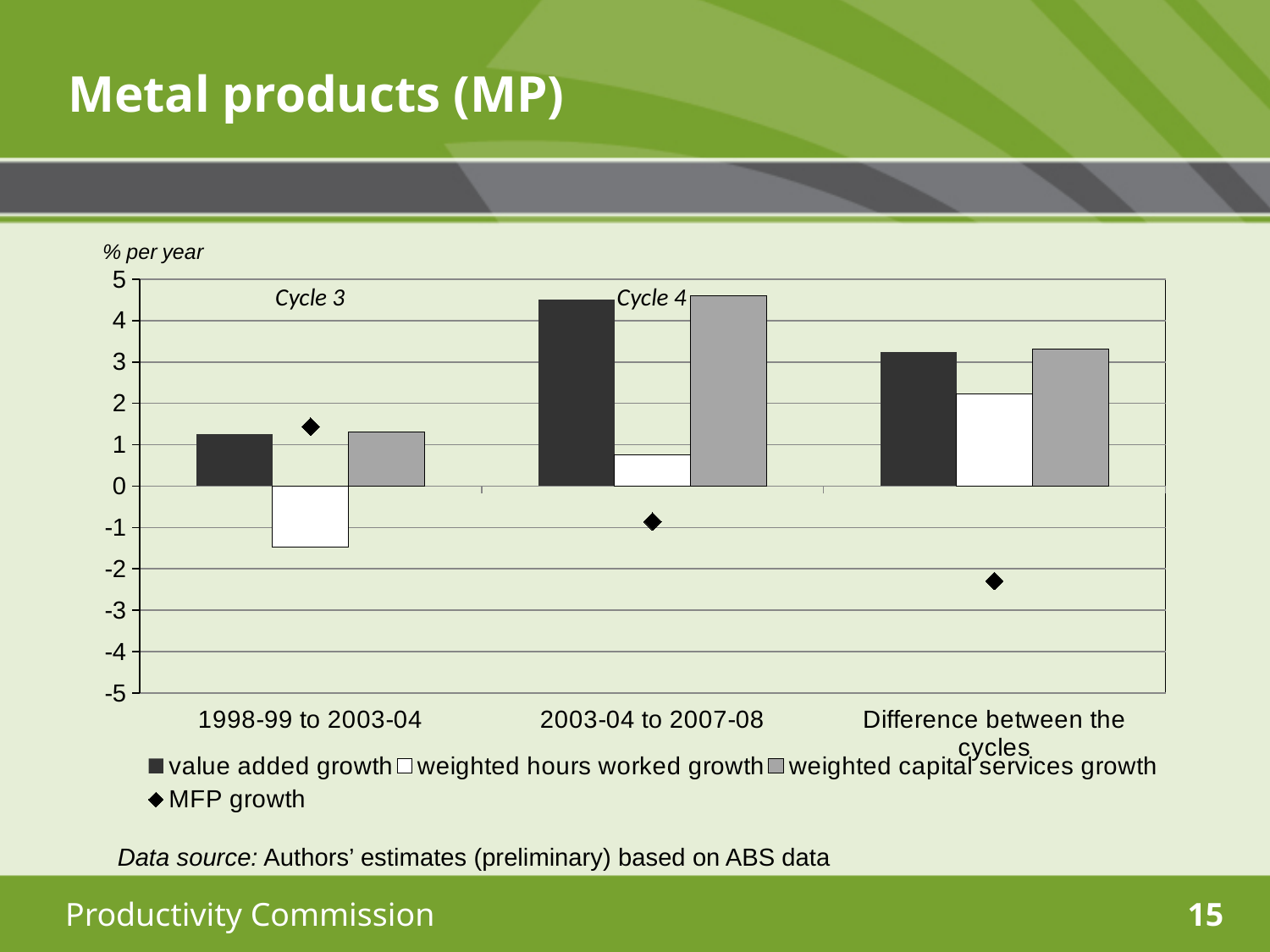
How many series does the legend list? 4 Is the weighted hours worked growth for 1998-99 to 2003-04 greater or less than -1? less What unit label is shown above the y axis? % per year Which category has the highest value added growth? 2003-04 to 2007-08 Which is larger: MFP growth for 1998-99 to 2003-04 or for 2003-04 to 2007-08? 1998-99 to 2003-04 Is the MFP growth for 2003-04 to 2007-08 greater or less than 0? less Does MFP growth rise or fall across the three categories from left to right? fall Which is larger: weighted hours worked growth for 1998-99 to 2003-04 or for 2003-04 to 2007-08? 2003-04 to 2007-08 Is the value added growth for 2003-04 to 2007-08 greater or less than 4? greater How many categories are shown along the x axis? 3 Which category has the lowest MFP growth? Difference between the cycles What kind of chart is shown on the slide? bar chart